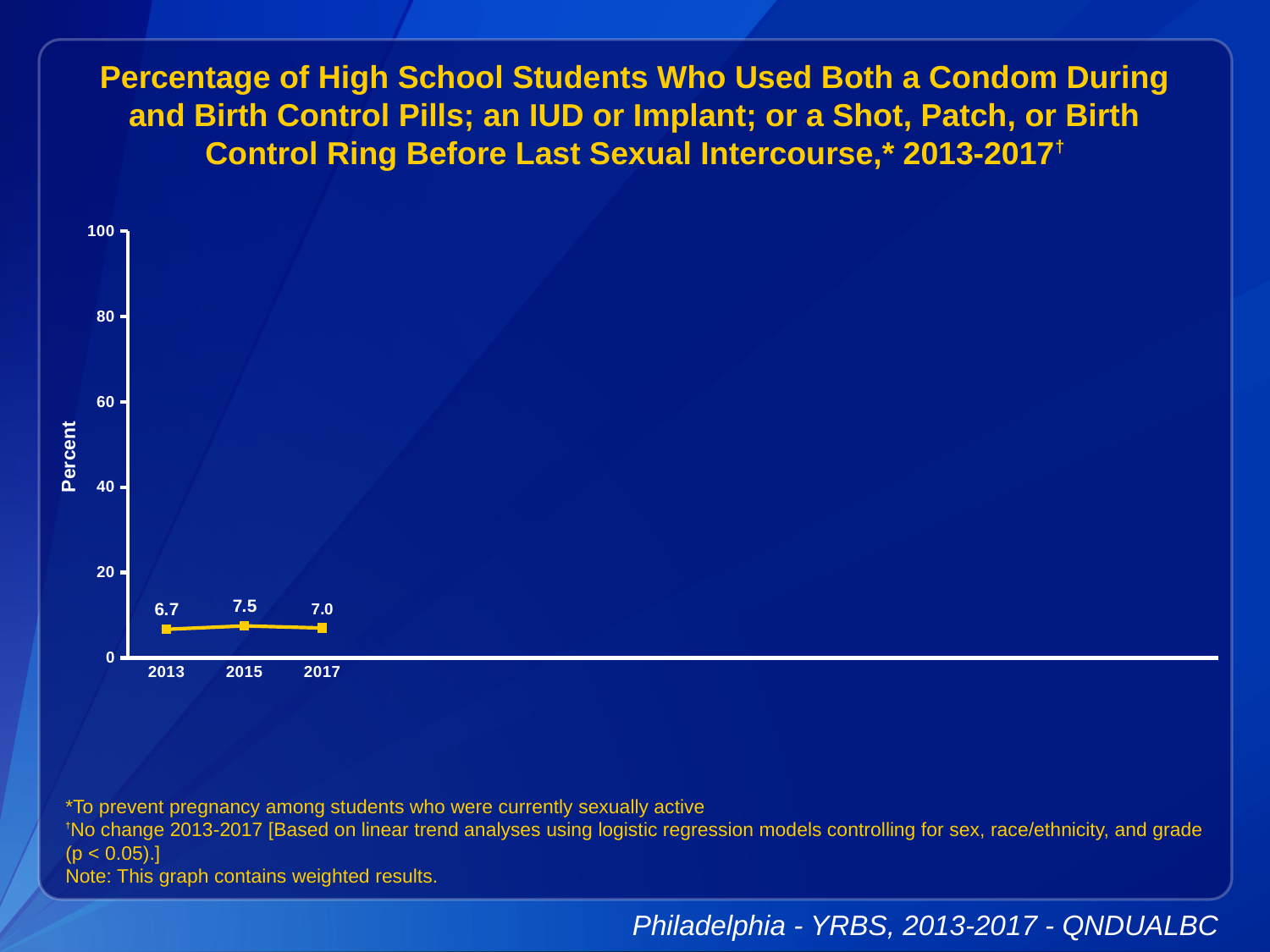
What is the value for 2013? 6.7 What is the label of the vertical axis? Percent Which year has the highest value? 2015 Which year has the lowest value? 2013 Is the value for 2015 greater or less than 20? less What is the value for 2015? 7.5 How many years are plotted on the chart? 3 What is the difference between the values for 2015 and 2013? 0.8 What is the value for 2017? 7.0 What kind of chart is shown on the slide? line chart What is the difference between the values for 2015 and 2017? 0.5 Which is larger, the value for 2017 or the value for 2013? 2017